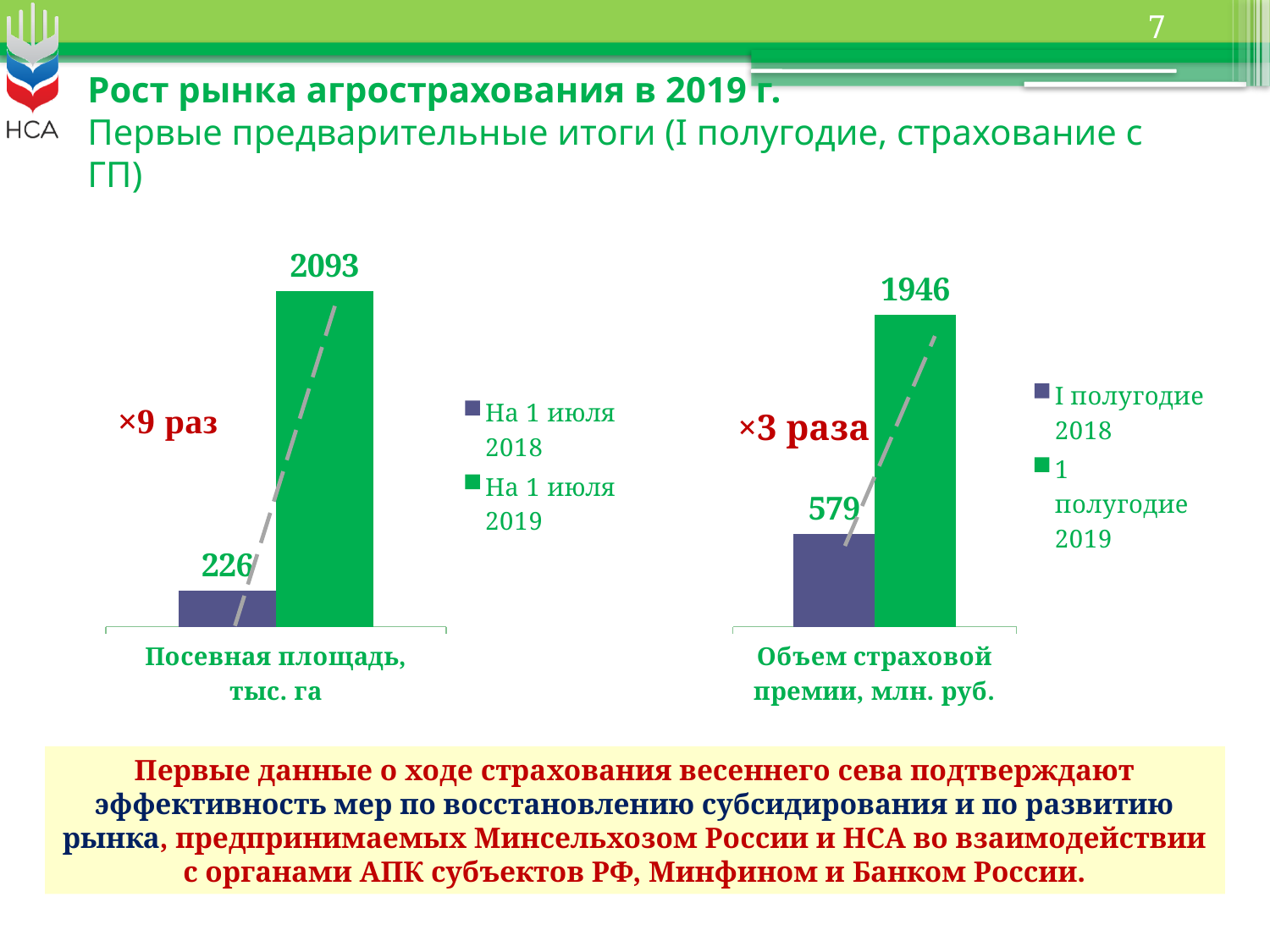
What growth factor is annotated on the left chart (Посевная площадь, тыс. га)? ×9 раз What type of chart is the right chart (Объем страховой премии, млн. руб.)? Bar chart In the left chart (Посевная площадь, тыс. га), what is the difference between the 2019 and 2018 values? 1867 In the left chart (Посевная площадь, тыс. га), what is the value for На 1 июля 2018? 226 In the right chart (Объем страховой премии, млн. руб.), what is the difference between the 2019 and 2018 values? 1367 In the left chart (Посевная площадь, тыс. га), what is the value for На 1 июля 2019? 2093 In the right chart (Объем страховой премии, млн. руб.), what is the value for 1 полугодие 2019? 1946 In the right chart (Объем страховой премии, млн. руб.), which series has the larger value, I полугодие 2018 or 1 полугодие 2019? 1 полугодие 2019 How many series does the legend of the left chart (Посевная площадь, тыс. га) list? 2 What growth factor is annotated on the right chart (Объем страховой премии, млн. руб.)? ×3 раза In the right chart (Объем страховой премии, млн. руб.), what is the value for I полугодие 2018? 579 In the left chart (Посевная площадь, тыс. га), which series has the smaller value? На 1 июля 2018